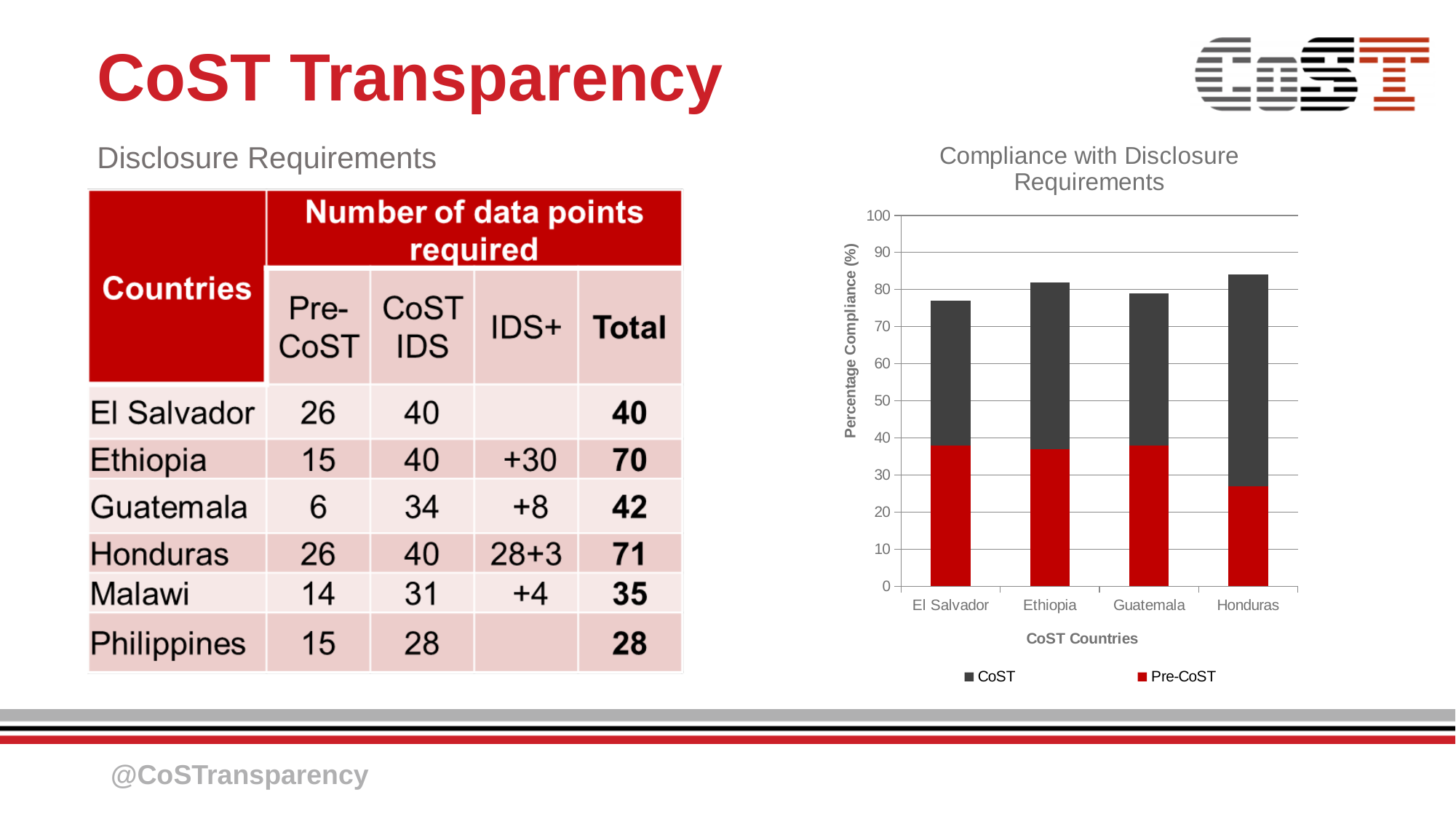
Which country has the tallest stacked bar in the chart? Honduras How many series does the chart legend list? 2 Which country has the lowest Pre-CoST compliance in the chart? Honduras What kind of chart is shown on the slide? stacked bar chart What is the label of the chart's y axis? Percentage Compliance (%) How many countries are shown on the x axis of the chart? 4 Is the top of the stacked bar for Honduras greater or less than 80? greater Which is larger, the Pre-CoST value for El Salvador or the Pre-CoST value for Honduras? El Salvador Is the Pre-CoST value for Guatemala greater or less than 30? greater Is the Pre-CoST value for Honduras greater or less than 30? less What is the title of the chart? Compliance with Disclosure Requirements